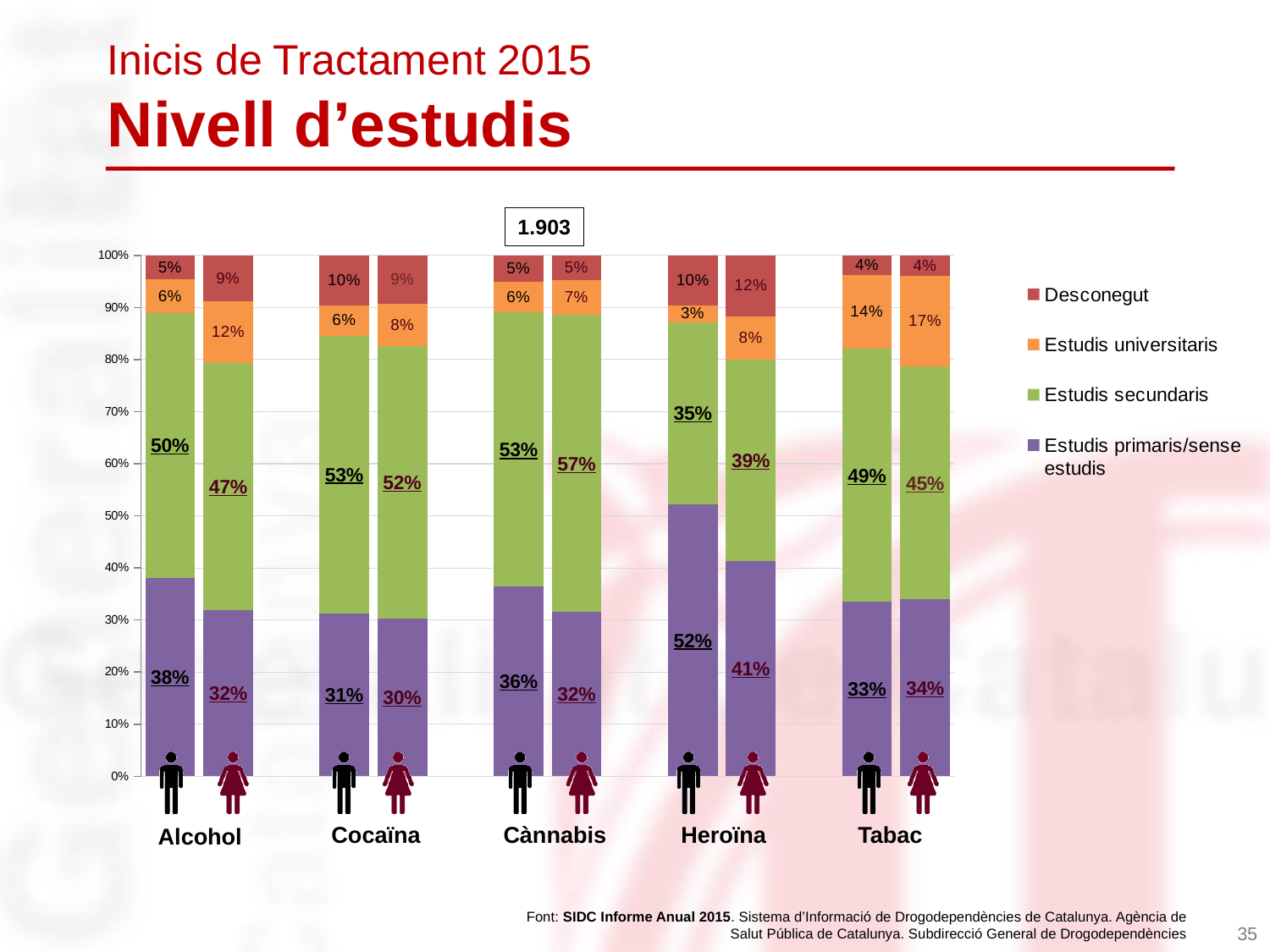
How many substance categories are shown on the x axis? 5 What is the Estudis secundaris percentage for women in the Cànnabis group? 57% What percentage of women starting treatment for Tabac have Estudis universitaris? 17% What is the difference between the Estudis universitaris share for women and for men in the Alcohol group? 6% What is the Desconegut percentage for women in the Heroïna group? 12% Which is larger: the Estudis secundaris share for men in the Cocaïna group or for men in the Heroïna group? Cocaïna men What percentage of men starting treatment for Heroïna have Estudis primaris/sense estudis? 52% Among the men's bars, which substance has the highest share of Estudis primaris/sense estudis? Heroïna How many series does the legend list? 4 Among the men's bars, which substance has the lowest share of Estudis universitaris? Heroïna What number is shown in the box above the chart? 1.903 What kind of chart is shown on the slide? Stacked bar chart